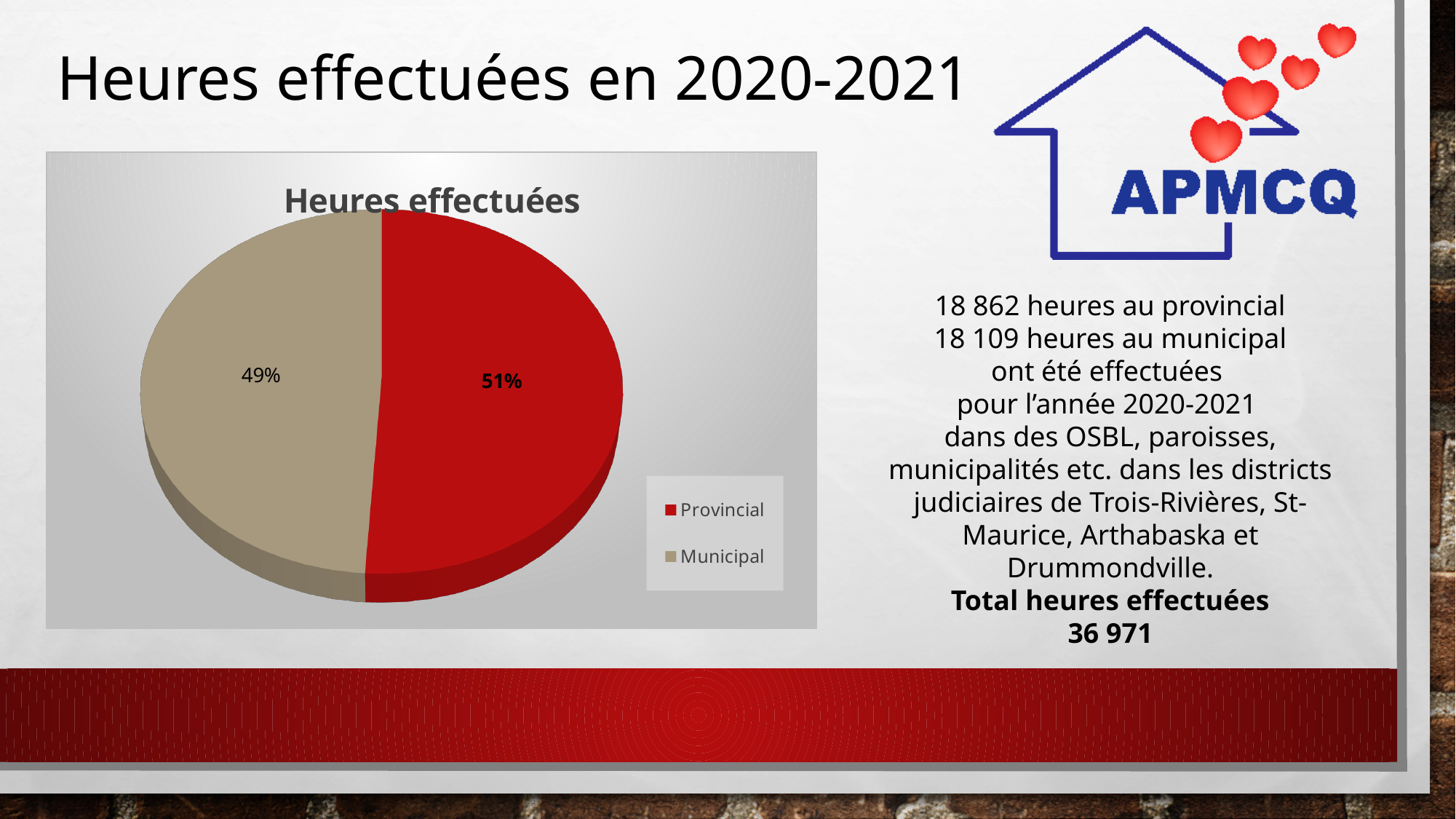
What colour is the Provincial slice in the pie chart? Red How many slices does the pie chart have? 2 What is the title of the chart? Heures effectuées What is the difference in percentage points between the Provincial and Municipal slices? 2% How many entries does the chart legend list? 2 Which slice is larger, Provincial or Municipal? Provincial What share of the pie does the Municipal slice represent? 49% What share of the pie does the Provincial slice represent? 51% Which category has the smallest share of the pie? Municipal Which category has the largest share of the pie? Provincial What kind of chart is shown on the slide? Pie chart